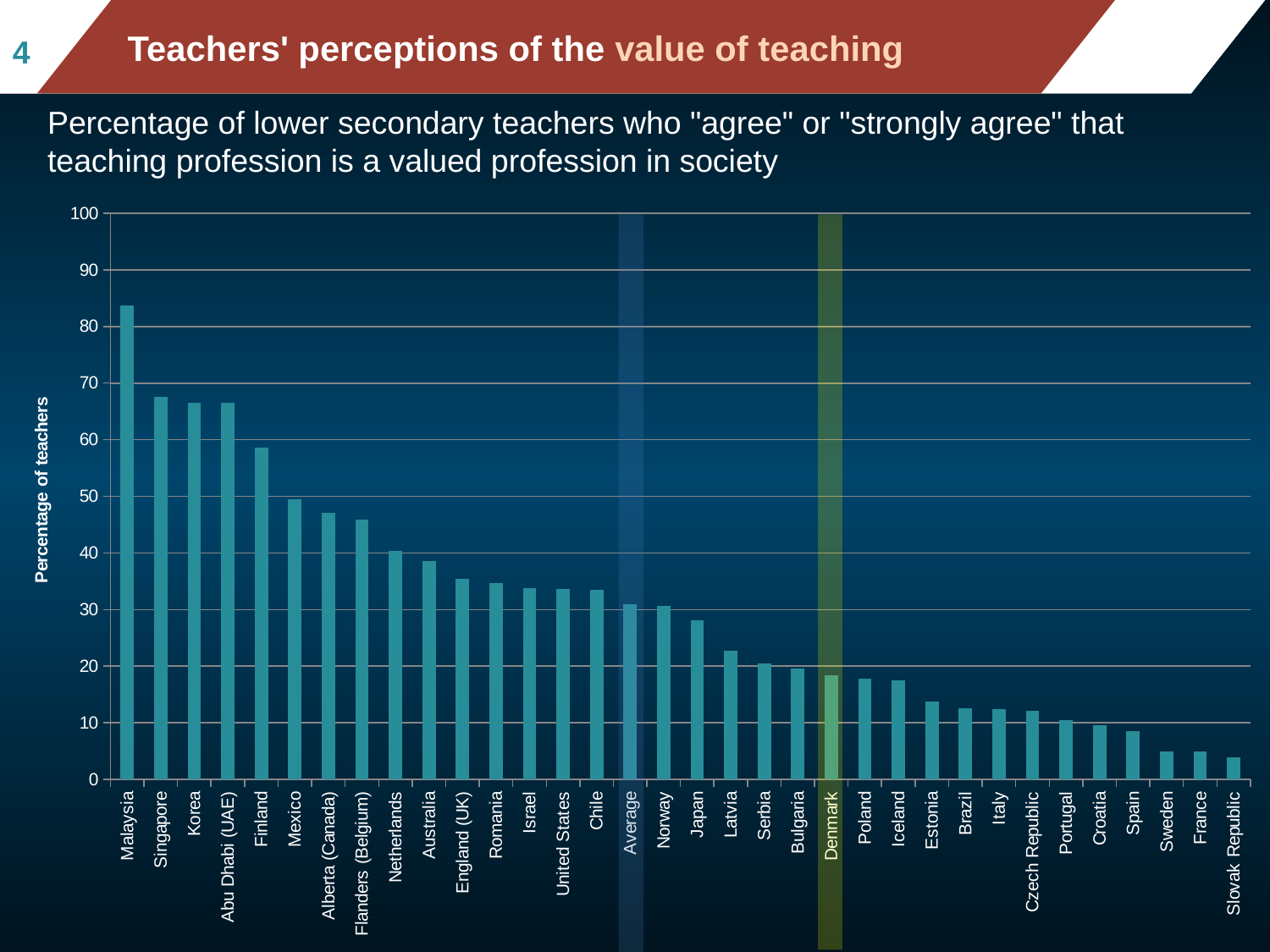
Is the value for Malaysia greater or less than 80? greater Which has a higher value, Finland or Mexico? Finland Is the value for Spain greater or less than 10? less Is the value for Denmark greater or less than 20? less How many bars (categories) are plotted on the chart? 34 Which country has the highest percentage of teachers who agree that teaching is a valued profession? Malaysia What is the title of the vertical axis? Percentage of teachers What kind of chart is shown on the slide? bar chart Do the values rise or fall moving from left to right along the x axis? fall Which has a higher value, Poland or Estonia? Poland